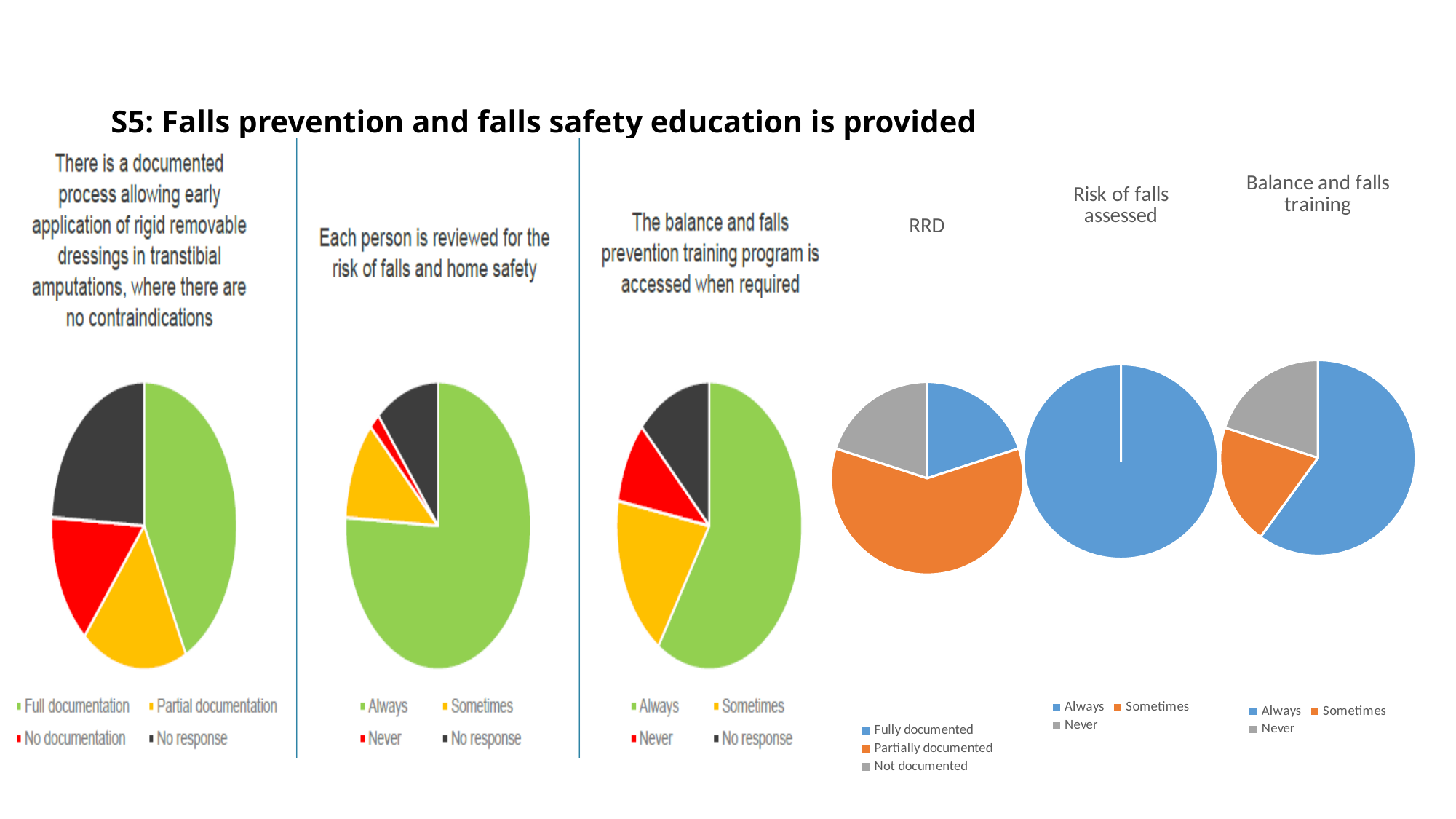
In the 'There is a documented process allowing early application of rigid removable dressings...' pie chart, which category has the smallest slice? No documentation What colour represents 'Never' in the 'Balance and falls training' pie chart? Grey In the 'Each person is reviewed for the risk of falls and home safety' pie chart, which category has the largest slice? Always What kind of chart is used for 'Each person is reviewed for the risk of falls and home safety'? Pie chart In the 'The balance and falls prevention training program is accessed when required' pie chart, which is larger: Always or Sometimes? Always In the 'There is a documented process allowing early application of rigid removable dressings...' pie chart, which category has the largest slice? Full documentation In the 'RRD' pie chart, which category has the largest slice? Partially documented In the 'Each person is reviewed for the risk of falls and home safety' pie chart, which category has the smallest slice? Never In the 'RRD' pie chart, which is larger: Fully documented or Partially documented? Partially documented How many categories does the legend of the 'RRD' pie chart list? 3